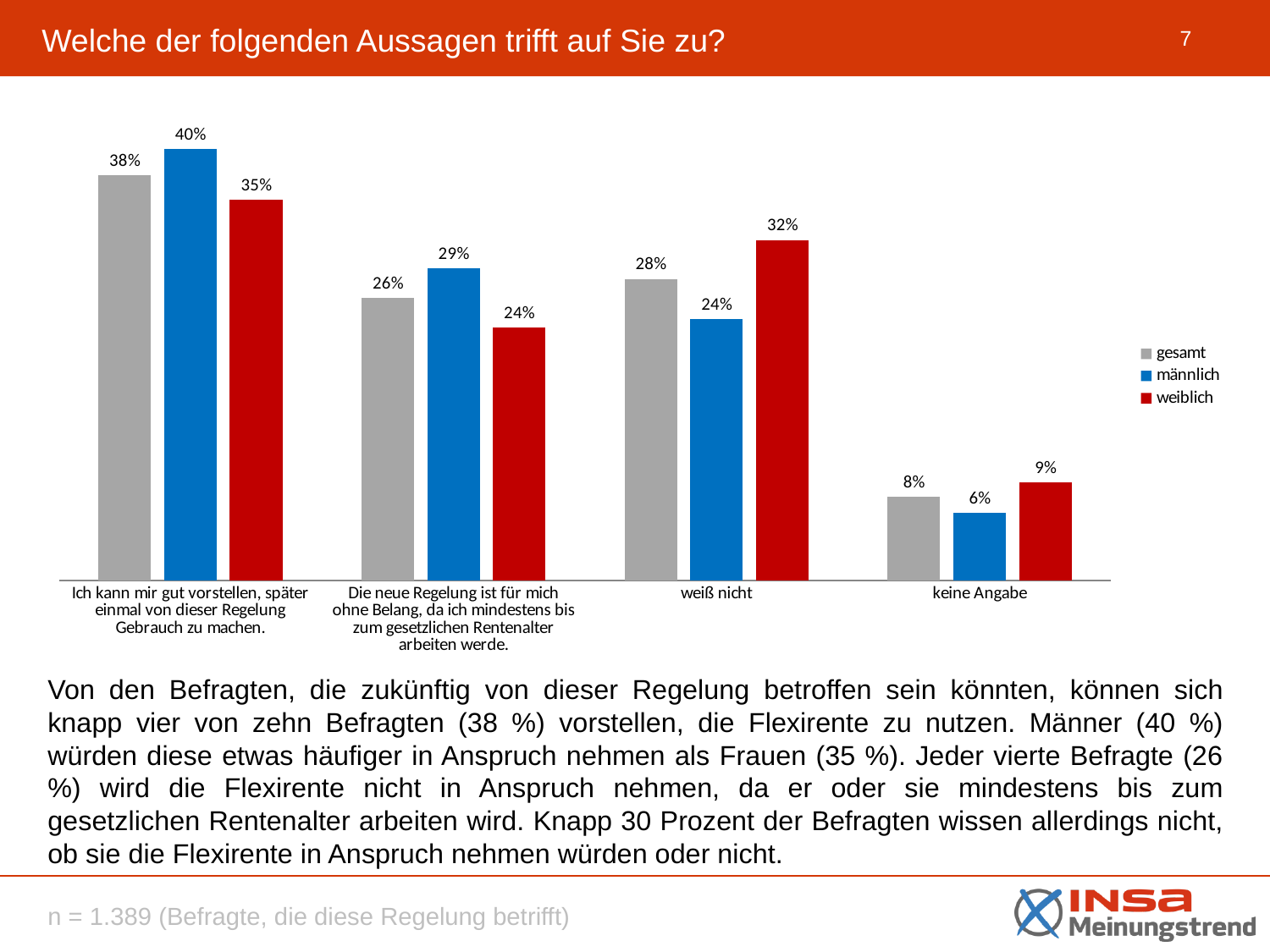
What kind of chart is shown on the slide? bar chart What is the difference between the "gesamt" values for "weiß nicht" and "keine Angabe"? 20% Which colour represents the series "weiblich" in the legend? red How many categories are shown on the x axis? 4 What is the difference between the "männlich" and "weiblich" values in the category "Ich kann mir gut vorstellen, später einmal von dieser Regelung Gebrauch zu machen."? 5% What is the value for "weiblich" in the category "Die neue Regelung ist für mich ohne Belang, da ich mindestens bis zum gesetzlichen Rentenalter arbeiten werde."? 24% How many series does the legend list? 3 What is the value for "gesamt" in the category "weiß nicht"? 28% Which category has the lowest value for "weiblich"? keine Angabe Which category has the highest value for "männlich"? Ich kann mir gut vorstellen, später einmal von dieser Regelung Gebrauch zu machen. What is the value for "männlich" in the category "keine Angabe"? 6% In the category "weiß nicht", which is larger: the value for "männlich" or for "weiblich"? weiblich